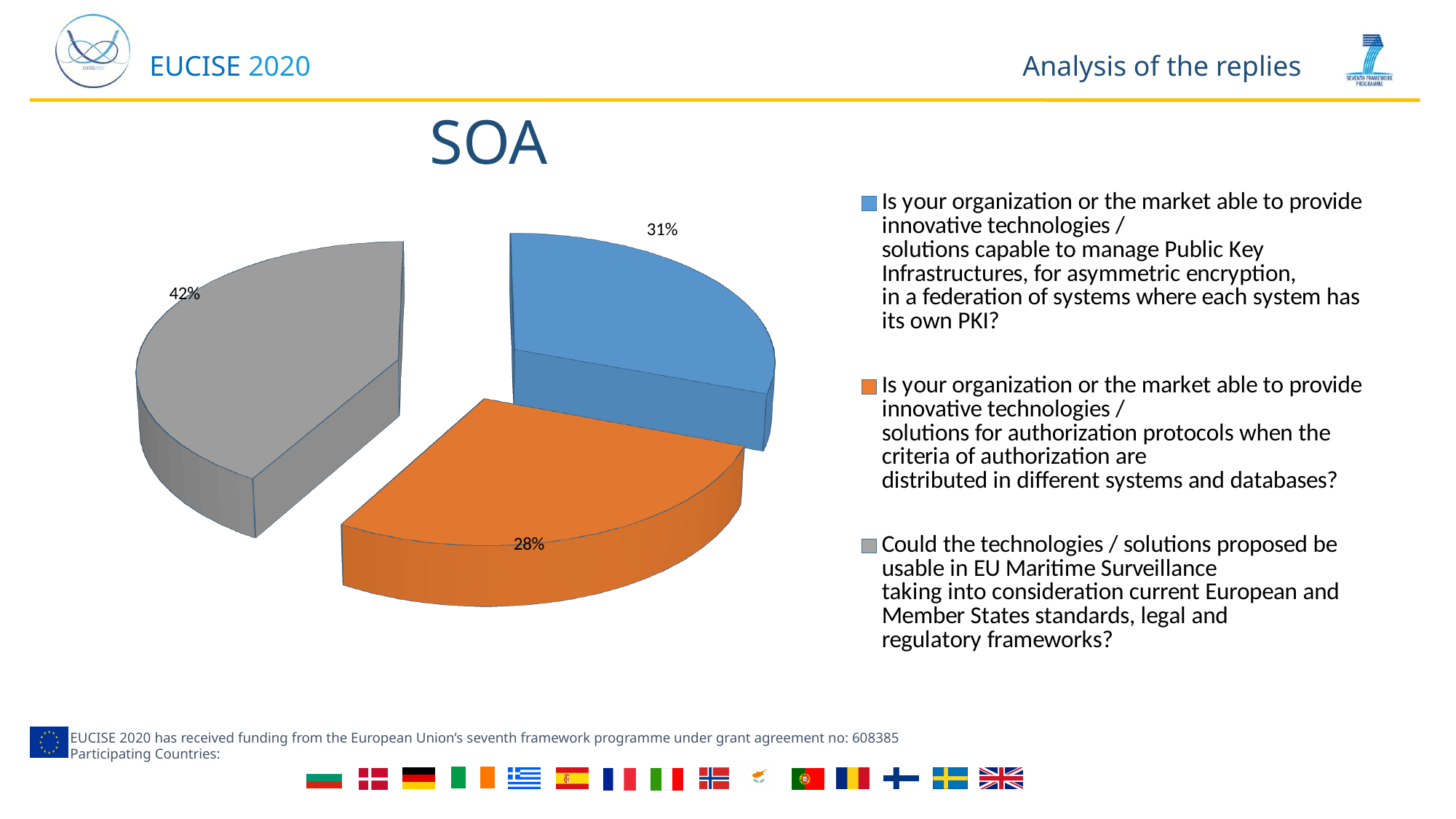
What percentage is shown for the grey slice (the question about usability in EU Maritime Surveillance)? 42% Which slice has the largest share of the pie? the grey slice (usable in EU Maritime Surveillance), 42% What percentage is shown for the blue slice (the question about managing Public Key Infrastructures)? 31% How many slices does the pie chart have? 3 Which is larger, the blue slice or the orange slice? the blue slice What percentage is shown for the orange slice (the question about authorization protocols)? 28% How many entries does the legend list? 3 What colour is the slice representing the question about authorization protocols? orange What kind of chart is shown on the slide? pie chart What is the title of the chart? SOA Which slice has the smallest share of the pie? the orange slice (authorization protocols), 28% What is the difference in percentage points between the grey slice and the orange slice? 14